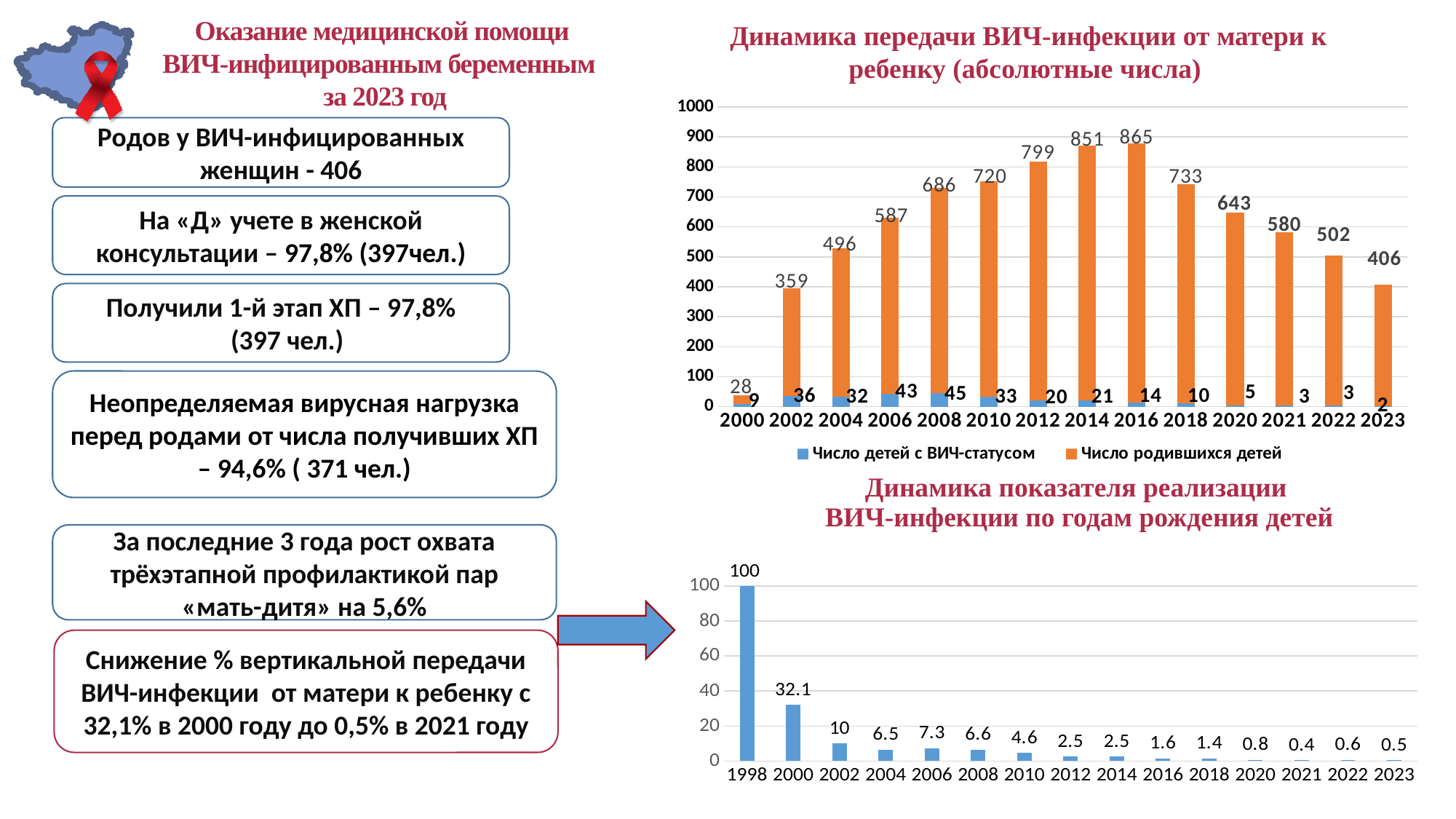
In the top chart 'Динамика передачи ВИЧ-инфекции от матери к ребенку', how many years are shown on the x axis? 14 In the top chart 'Динамика передачи ВИЧ-инфекции от матери к ребенку', which year has the lowest value of 'Число детей с ВИЧ-статусом'? 2023 In the bottom chart 'Динамика показателя реализации ВИЧ-инфекции по годам рождения детей', what is the value for 2000? 32.1 In the top chart 'Динамика передачи ВИЧ-инфекции от матери к ребенку', which colour represents 'Число родившихся детей'? Orange In the bottom chart 'Динамика показателя реализации ВИЧ-инфекции по годам рождения детей', which year has the lowest value? 2021 In the top chart 'Динамика передачи ВИЧ-инфекции от матери к ребенку', what is the value of 'Число детей с ВИЧ-статусом' for 2008? 45 In the bottom chart 'Динамика показателя реализации ВИЧ-инфекции по годам рождения детей', do the values generally rise or fall from 1998 to 2023? Fall In the top chart 'Динамика передачи ВИЧ-инфекции от матери к ребенку', how many series does the legend list? 2 In the top chart 'Динамика передачи ВИЧ-инфекции от матери к ребенку', which year has the highest value of 'Число родившихся детей'? 2016 In the top chart 'Динамика передачи ВИЧ-инфекции от матери к ребенку', what is the value of 'Число родившихся детей' for 2016? 865 In the top chart 'Динамика передачи ВИЧ-инфекции от матери к ребенку', what is the difference between 'Число родившихся детей' in 2014 and in 2023? 445 In the bottom chart 'Динамика показателя реализации ВИЧ-инфекции по годам рождения детей', what kind of chart is shown? Bar chart